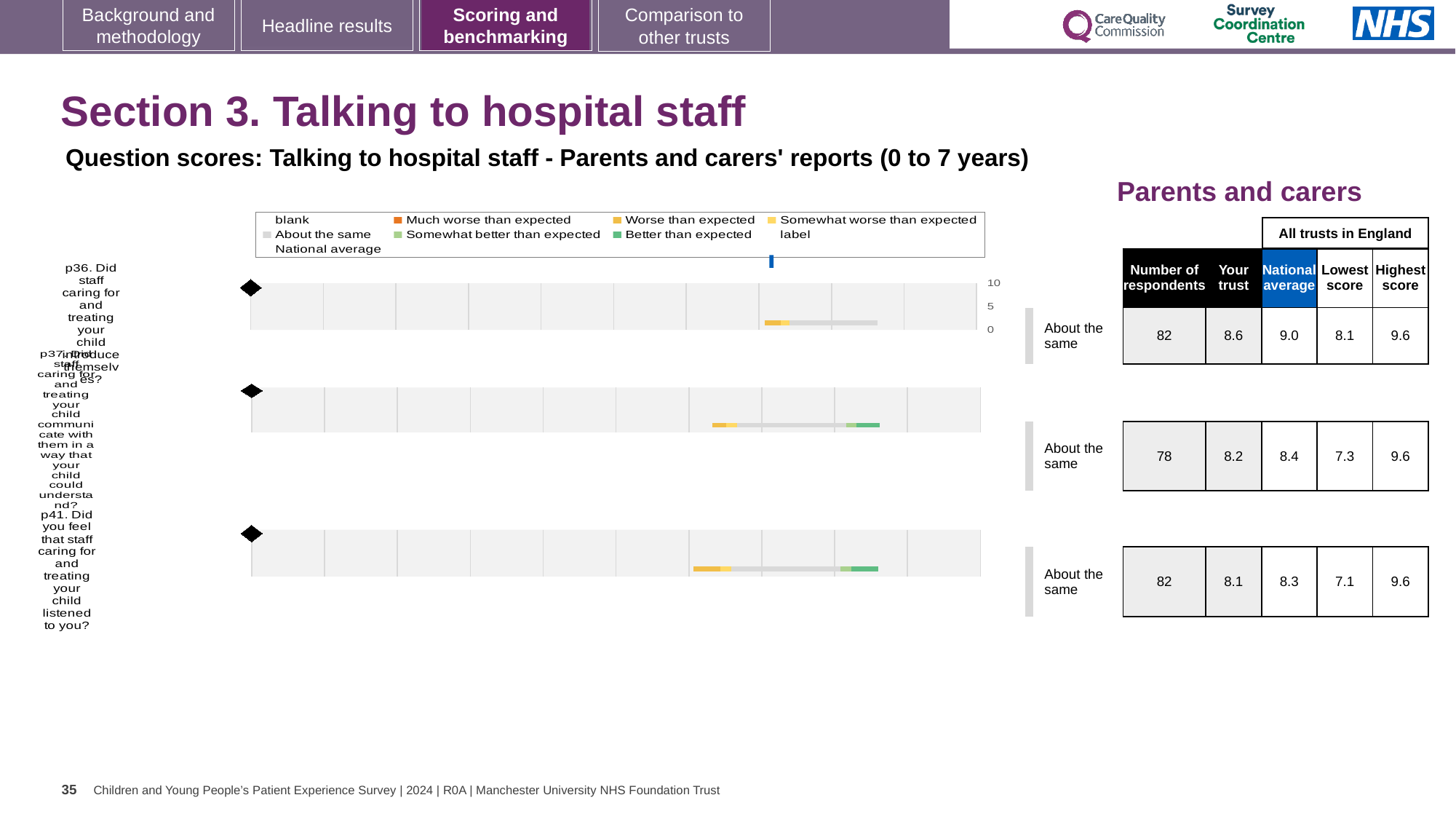
How many questions (p36, p37, p41) are plotted as separate chart rows on this slide? 3 Which of the three questions has the highest 'Your trust' score? p36 Which legend entry is shown in dark blue on the chart? National average What is the difference between the National average and the 'Your trust' score for p36? 0.4 What kind of chart is used to show the question scores on this slide? bar chart How many respondents answered p37? 78 What is the National average score for p37 (Did staff communicate with them in a way that your child could understand?)? 8.4 What is the highest value shown on the chart's numeric axis? 10 Which of the three questions has the lowest 'Your trust' score? p41 What is the 'Your trust' score for p36 (Did staff caring for and treating your child introduce themselves?)? 8.6 What is the Lowest score across all trusts in England for p41 (Did you feel that staff caring for and treating your child listened to you?)? 7.1 Is the 'Your trust' score for p41 larger or smaller than the National average for p41? smaller